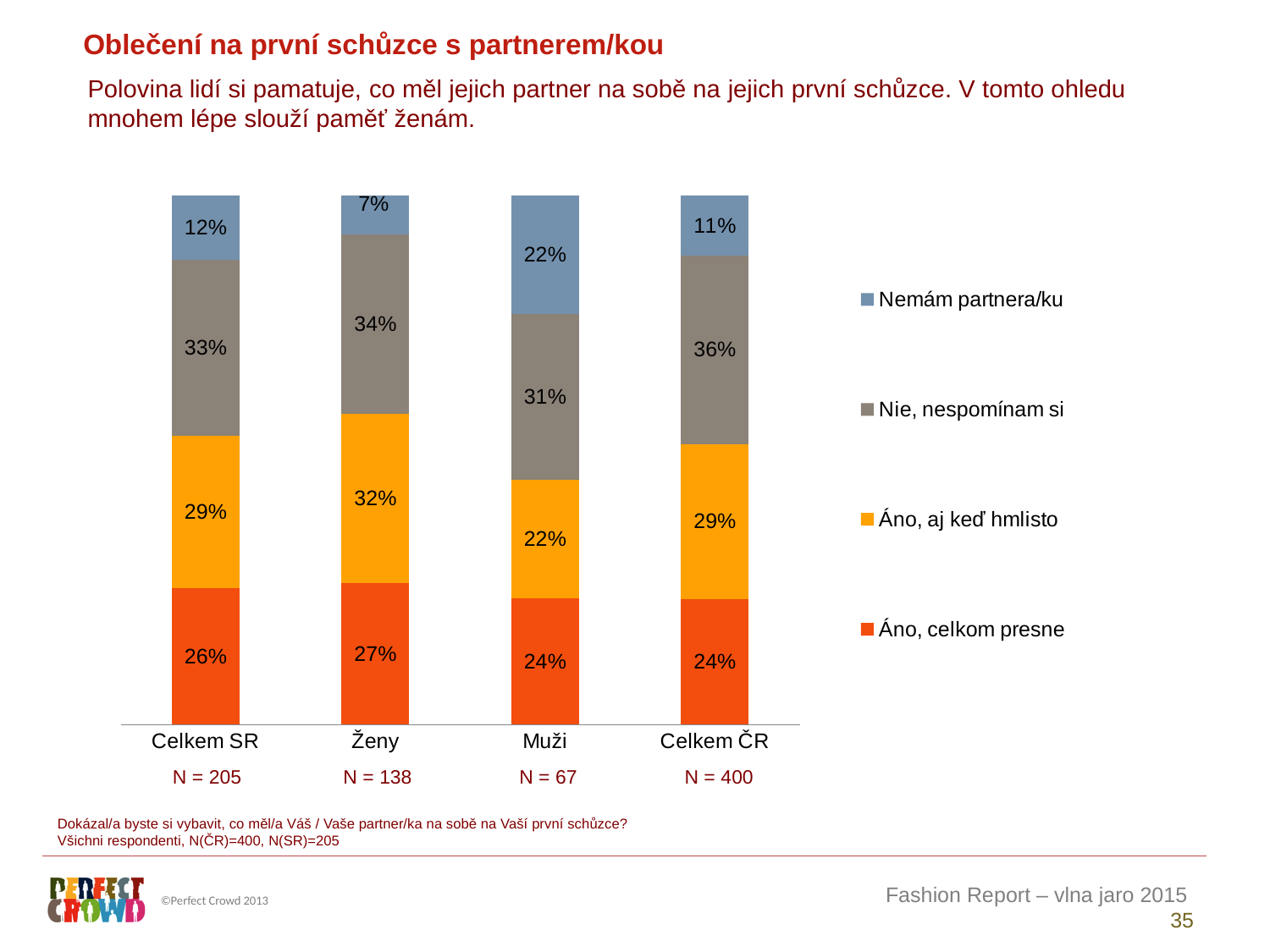
What is the value of "Áno, celkom presne" for Ženy? 27% What is the difference between the "Áno, aj keď hmlisto" values for Ženy and Muži? 10% What is the value of "Áno, aj keď hmlisto" for Celkem SR? 29% What is the value of "Nemám partnera/ku" for Muži? 22% How many series does the legend list? 4 How many categories are shown on the x axis of the chart? 4 Which category has the highest value for "Nie, nespomínam si"? Celkem ČR What is the sample size (N) shown for Celkem ČR? N = 400 Which is larger: the "Nemám partnera/ku" value for Celkem SR or for Muži? Muži Which category has the lowest value for "Nemám partnera/ku"? Ženy What is the value of "Nie, nespomínam si" for Celkem ČR? 36% What kind of chart is shown on the slide? Stacked bar chart